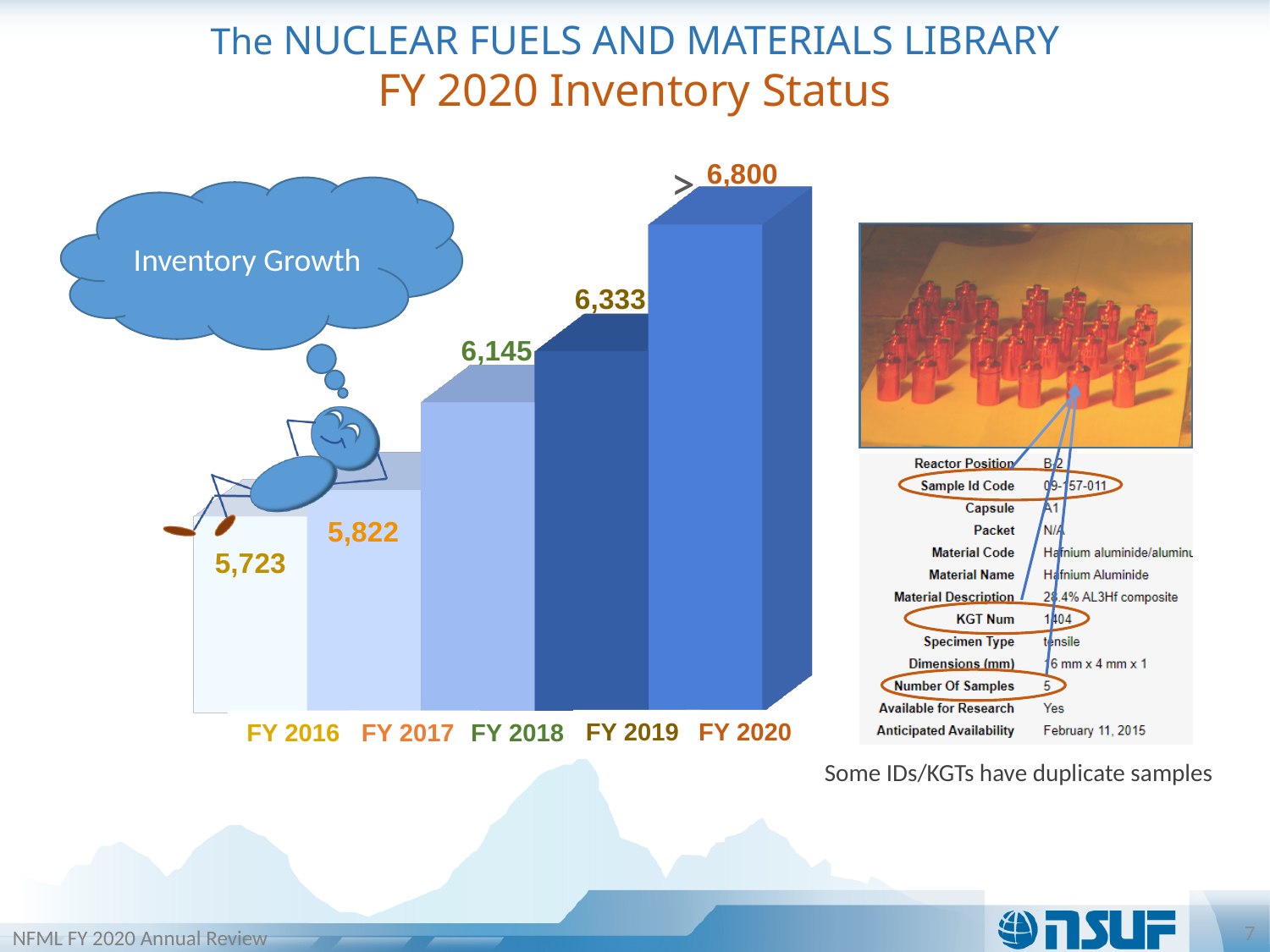
What is the inventory value shown for FY 2016? 5,723 What is the inventory value shown for FY 2018? 6,145 Which fiscal year has the lowest inventory value in the chart? FY 2016 How many fiscal years are shown in the inventory chart? 5 Is the inventory value for FY 2020 greater or less than 6,800? greater What is the difference between the FY 2019 and FY 2018 inventory values? 188 What is the inventory value shown for FY 2019? 6,333 What is the inventory value shown for FY 2017? 5,822 What is the difference between the FY 2017 and FY 2016 inventory values? 99 Which is larger, the inventory value for FY 2018 or for FY 2017? FY 2018 Which fiscal year has the highest inventory value in the chart? FY 2020 Do the inventory values rise or fall from FY 2016 to FY 2020? rise